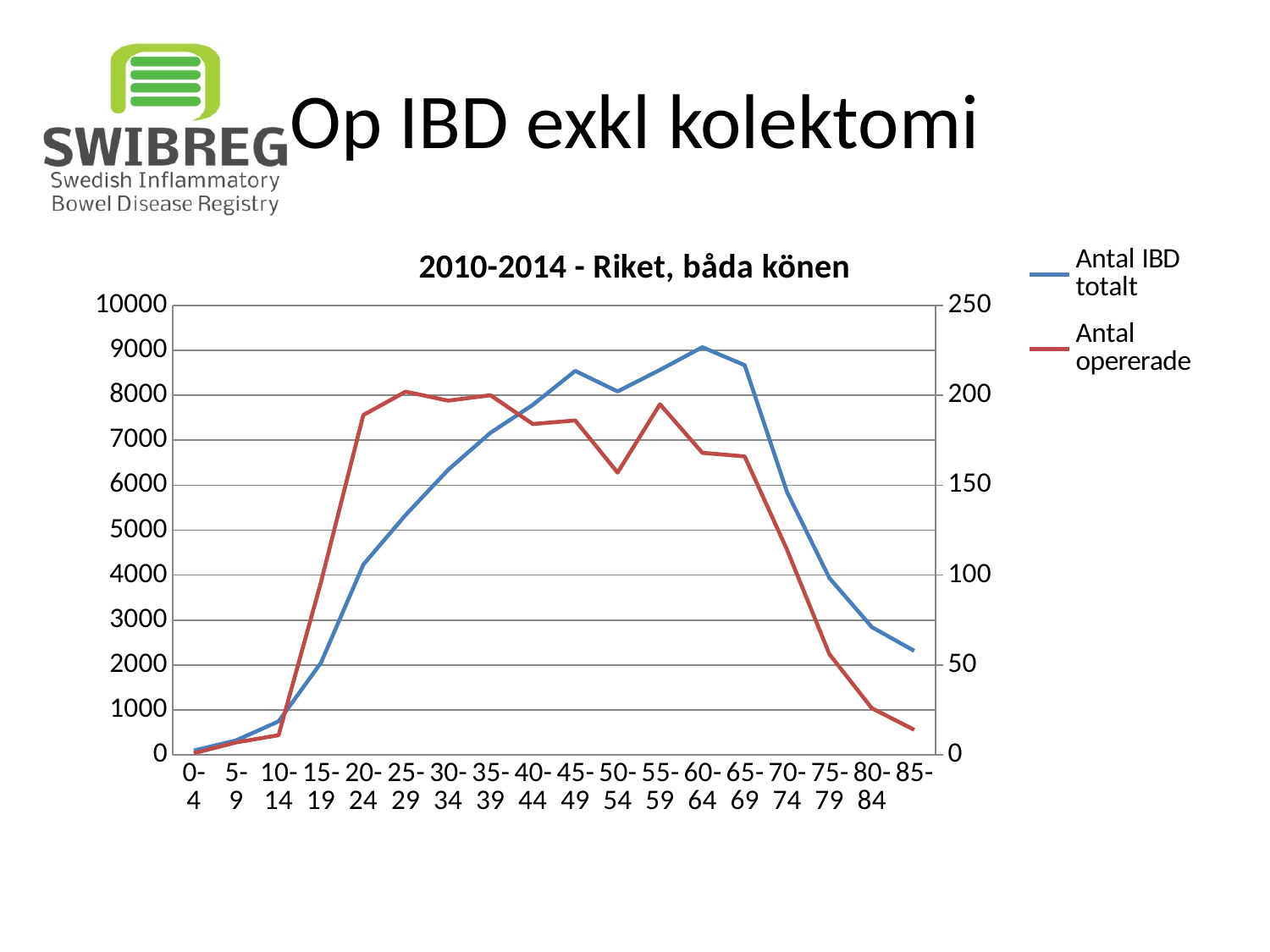
Which age group has the lowest value for Antal IBD totalt? 0-4 Does Antal IBD totalt rise or fall from the 65-69 age group to the 85- age group? fall Which age group has the lowest value for Antal opererade? 0-4 Is the value for Antal IBD totalt in the 85- age group greater or less than 2000? greater Which is larger for Antal opererade: the 50-54 age group or the 55-59 age group? 55-59 How many age-group categories are shown on the x axis? 18 Is the value for Antal IBD totalt in the 45-49 age group greater or less than 8000? greater Is the value for Antal opererade in the 20-24 age group greater or less than 200? less How many series does the legend list? 2 Which age group has the highest value for Antal IBD totalt? 60-64 What kind of chart is shown on the slide? line chart